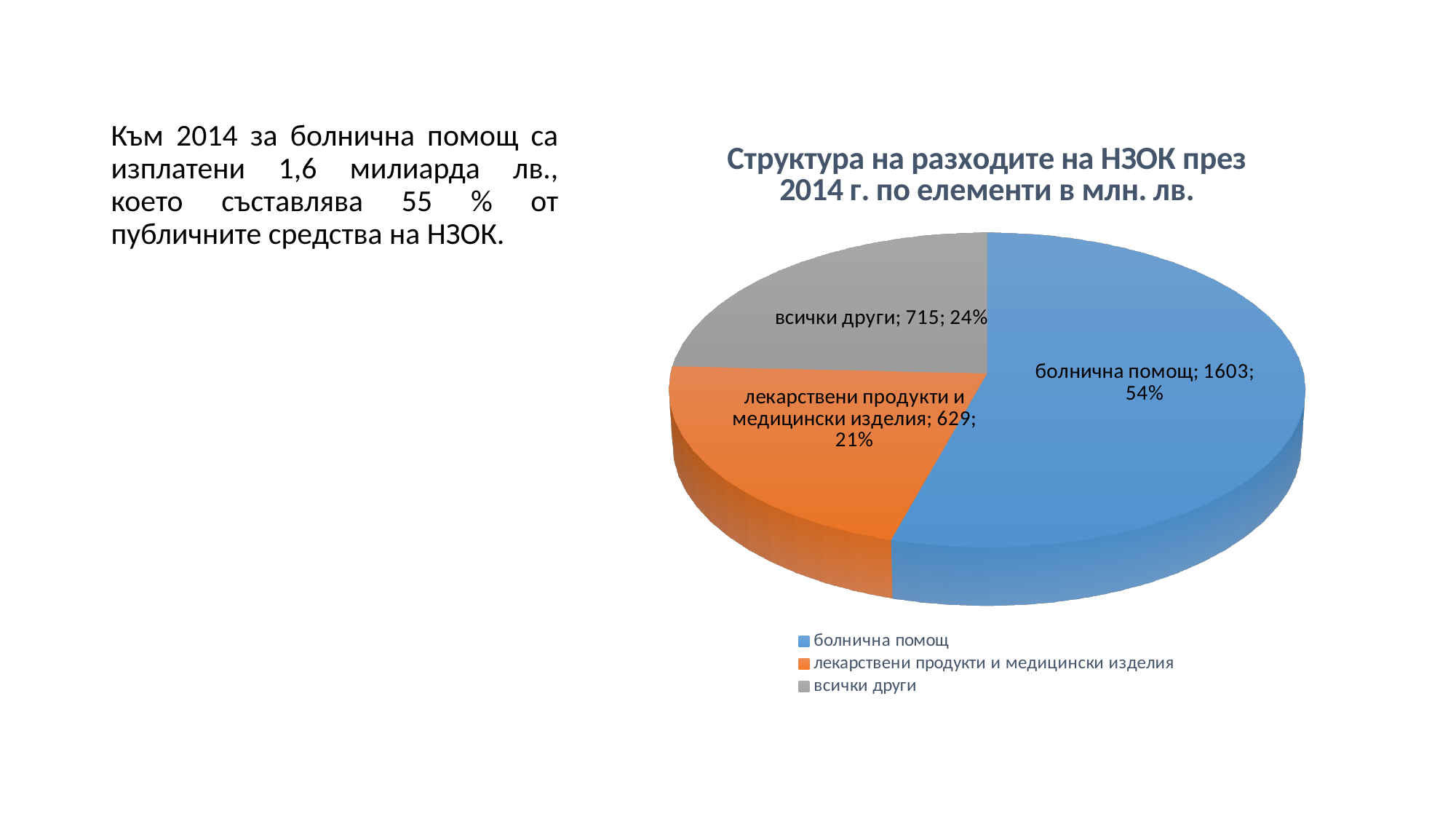
Which category has the highest value? болнична помощ How many slices does the pie chart have? 3 What is the value for болнична помощ? 1603 What is the value for всички други? 715 What is the difference between the values for болнична помощ and всички други? 888 What share of the pie does болнична помощ represent? 54% Which category has the lowest value? лекарствени продукти и медицински изделия What is the title of the chart? Структура на разходите на НЗОК през 2014 г. по елементи в млн. лв. What is the value for лекарствени продукти и медицински изделия? 629 What kind of chart is shown on the slide? pie chart Which is larger, всички други or лекарствени продукти и медицински изделия? всички други What share of the pie does лекарствени продукти и медицински изделия represent? 21%